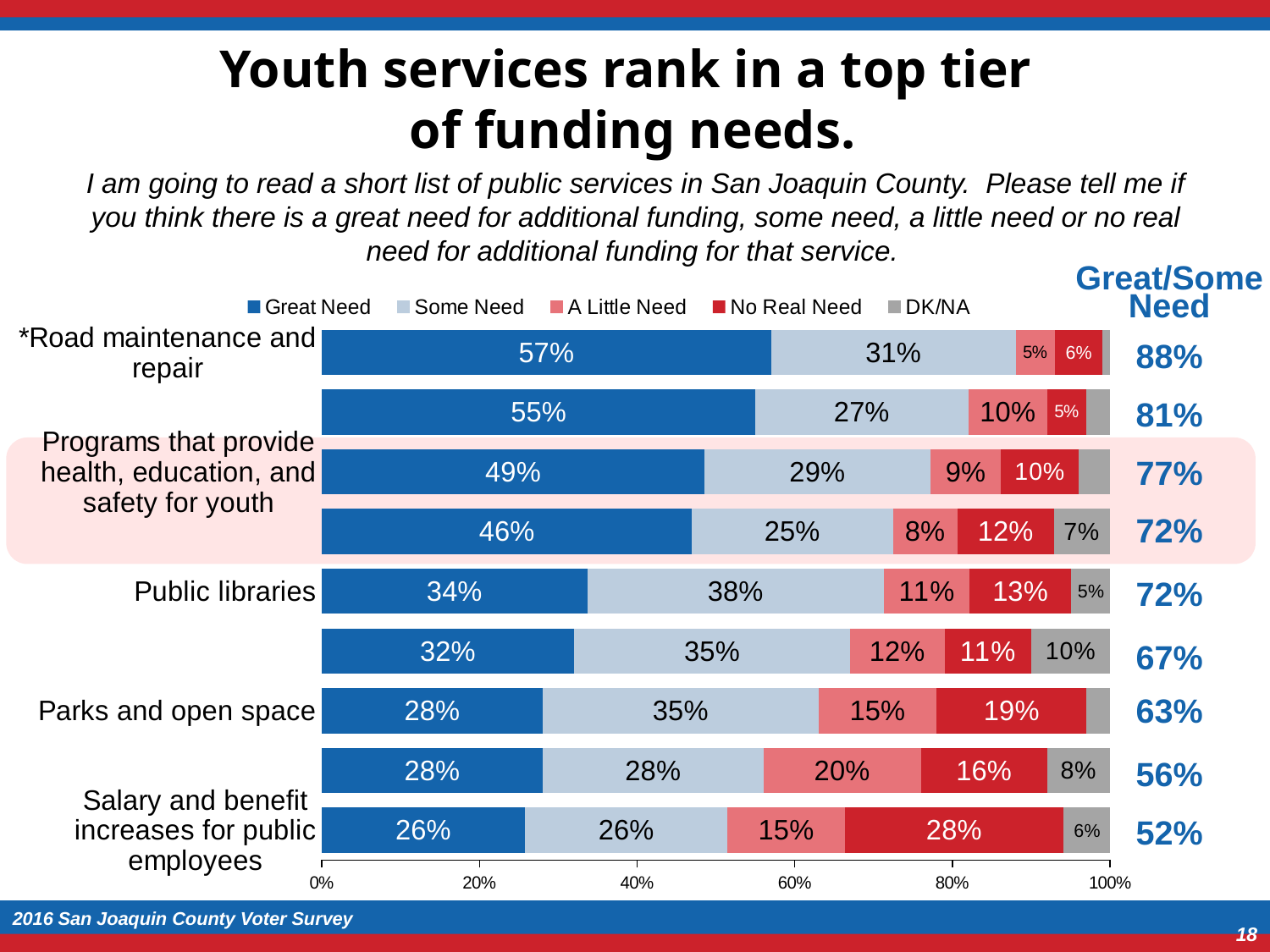
Which service has the highest Great Need percentage? Road maintenance and repair What is the Great/Some Need total shown for Public libraries? 72% What kind of chart is shown on the slide? Stacked bar chart What is the Some Need value for Public libraries? 38% What percentage of respondents said there is a Great Need for funding for Road maintenance and repair? 57% How many bars (service categories) are plotted in the chart? 9 How many percentage points higher is the Great Need value for Road maintenance and repair than for Public libraries? 23 percentage points Which has a larger Some Need value: Public libraries or Parks and open space? Public libraries How many series does the chart legend list? 5 Which service has the lowest Great Need percentage? Salary and benefit increases for public employees What is the No Real Need value for Parks and open space? 19% What is the No Real Need value for Salary and benefit increases for public employees? 28%